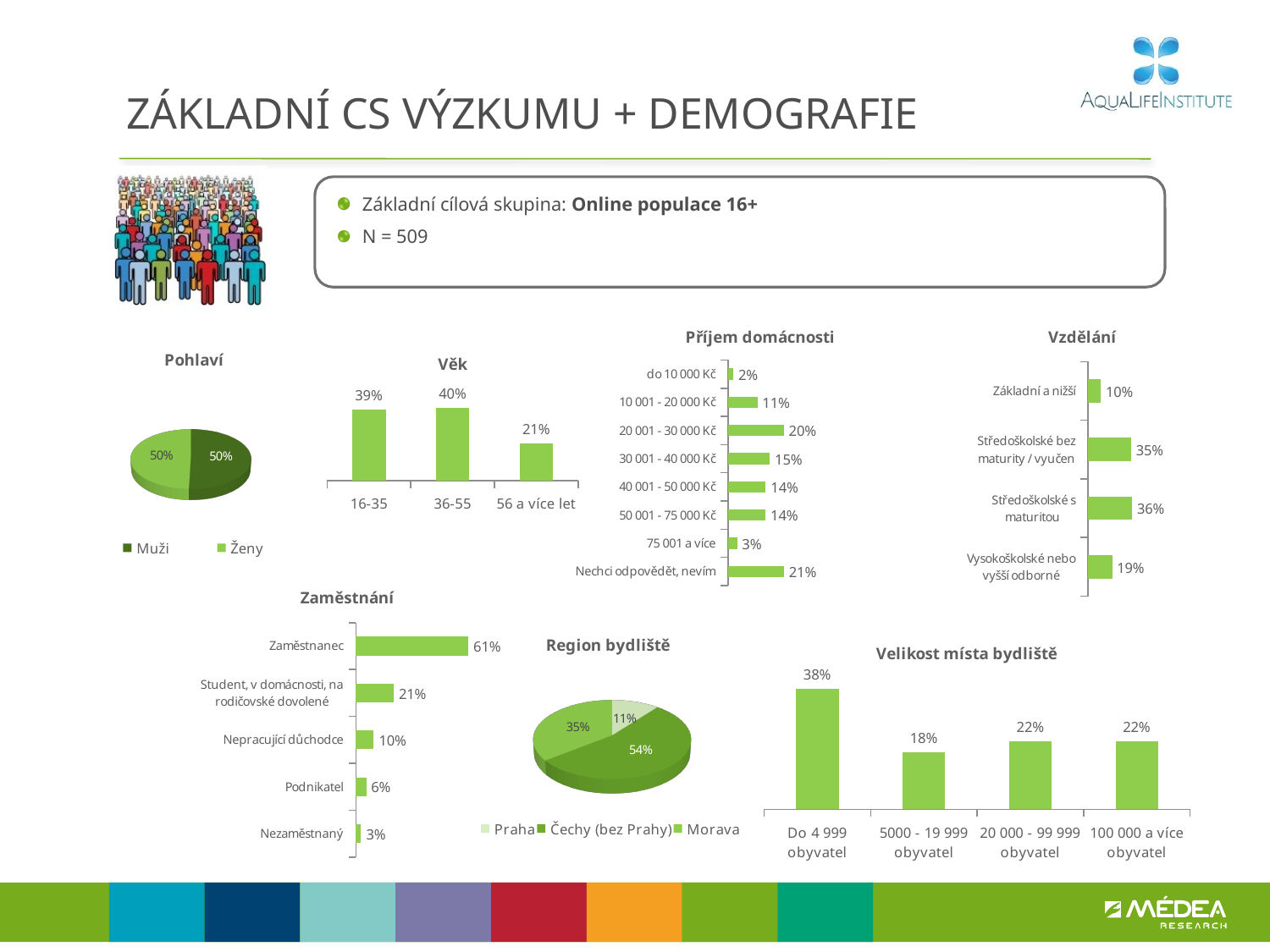
In the 'Příjem domácnosti' chart, what is the value for '20 001 - 30 000 Kč'? 20% What kind of chart is the 'Pohlaví' chart? Pie chart In the 'Zaměstnání' chart, which category has the highest value? Zaměstnanec In the 'Region bydliště' chart, what share of the pie does 'Čechy (bez Prahy)' have? 54% In the 'Příjem domácnosti' chart, how many categories are shown? 8 In the 'Zaměstnání' chart, what is the value for 'Podnikatel'? 6% In the 'Vzdělání' chart, what is the difference between 'Středoškolské s maturitou' and 'Základní a nižší'? 26% In the 'Vzdělání' chart, what is the value for 'Vysokoškolské nebo vyšší odborné'? 19% In the 'Velikost místa bydliště' chart, which of 'Do 4 999 obyvatel' or '5000 - 19 999 obyvatel' has the larger value? Do 4 999 obyvatel In the 'Věk' chart, what is the value for the 36-55 category? 40% In the 'Věk' chart, which age category has the lowest value? 56 a více let In the 'Příjem domácnosti' chart, which category has the lowest value? do 10 000 Kč